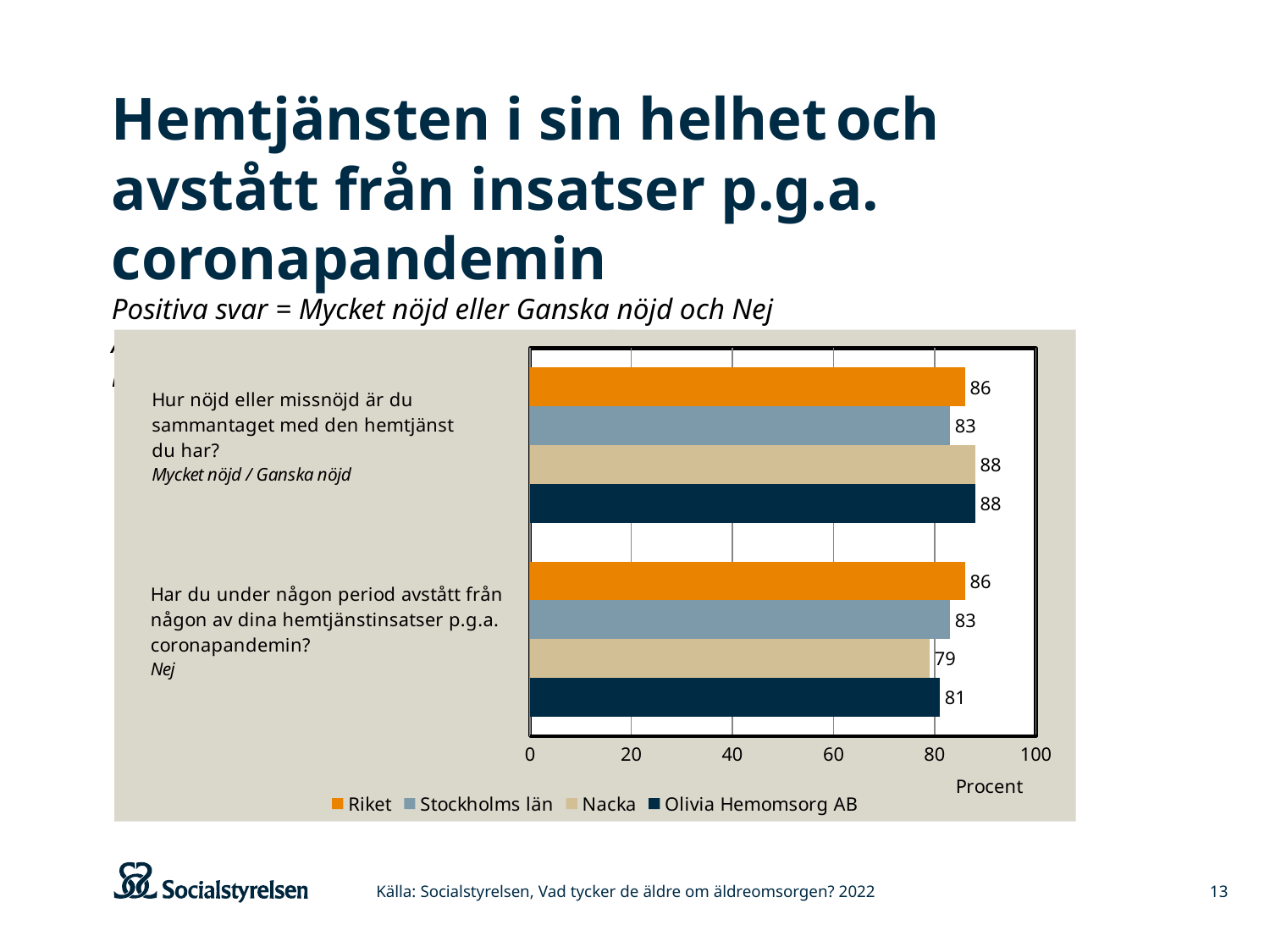
How many question categories are shown on the chart? 2 Which is larger on the question 'Hur nöjd eller missnöjd är du sammantaget med den hemtjänst du har?': the value for Nacka or the value for Stockholms län? Nacka What is the difference between the Riket value and the Nacka value on the question 'Har du under någon period avstått från någon av dina hemtjänstinsatser p.g.a. coronapandemin?'? 7 How many series does the legend list? 4 What is the value for Riket on the question 'Hur nöjd eller missnöjd är du sammantaget med den hemtjänst du har?'? 86 What is the value for Stockholms län on the question 'Har du under någon period avstått från någon av dina hemtjänstinsatser p.g.a. coronapandemin?'? 83 What kind of chart is shown on the slide? bar chart What is the value for Nacka on the question 'Har du under någon period avstått från någon av dina hemtjänstinsatser p.g.a. coronapandemin?'? 79 What unit label is shown on the horizontal axis of the chart? Procent What is the value for Olivia Hemomsorg AB on the question 'Hur nöjd eller missnöjd är du sammantaget med den hemtjänst du har?'? 88 Which series has the lowest value on the question 'Hur nöjd eller missnöjd är du sammantaget med den hemtjänst du har?'? Stockholms län Which series has the lowest value on the question 'Har du under någon period avstått från någon av dina hemtjänstinsatser p.g.a. coronapandemin?'? Nacka